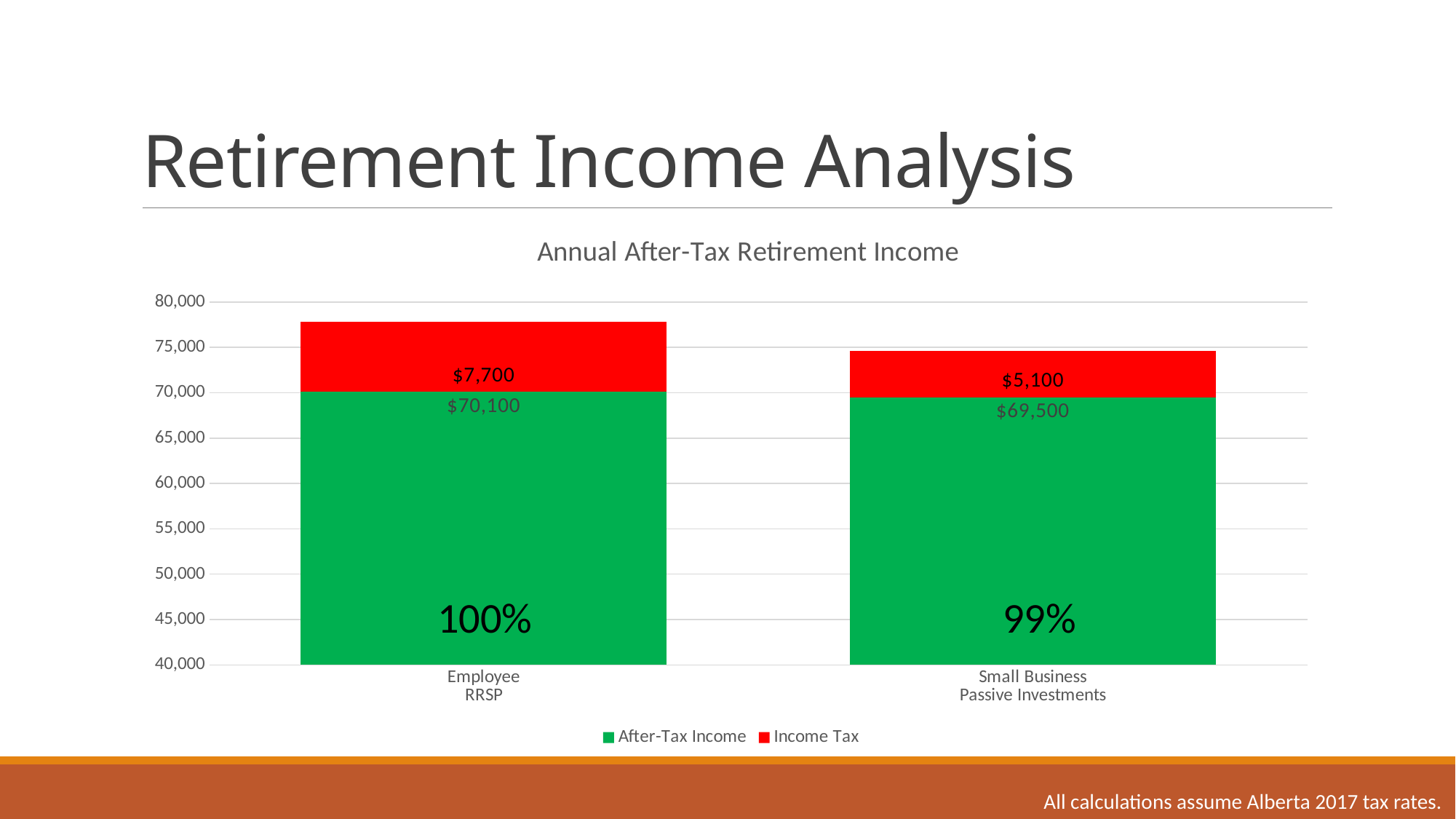
What is the After-Tax Income value for Employee RRSP? $70,100 What is the difference between the Income Tax values for Employee RRSP and Small Business Passive Investments? $2,600 What is the Income Tax value for Small Business Passive Investments? $5,100 What is the total of the stacked bar for Small Business Passive Investments? $74,600 What is the total of the stacked bar for Employee RRSP? $77,800 Which category has the higher Income Tax value? Employee RRSP What is the title of the chart? Annual After-Tax Retirement Income How many categories are shown on the x axis? 2 What is the After-Tax Income value for Small Business Passive Investments? $69,500 What is the difference between the After-Tax Income values for Employee RRSP and Small Business Passive Investments? $600 What is the Income Tax value for Employee RRSP? $7,700 How many series does the legend list? 2